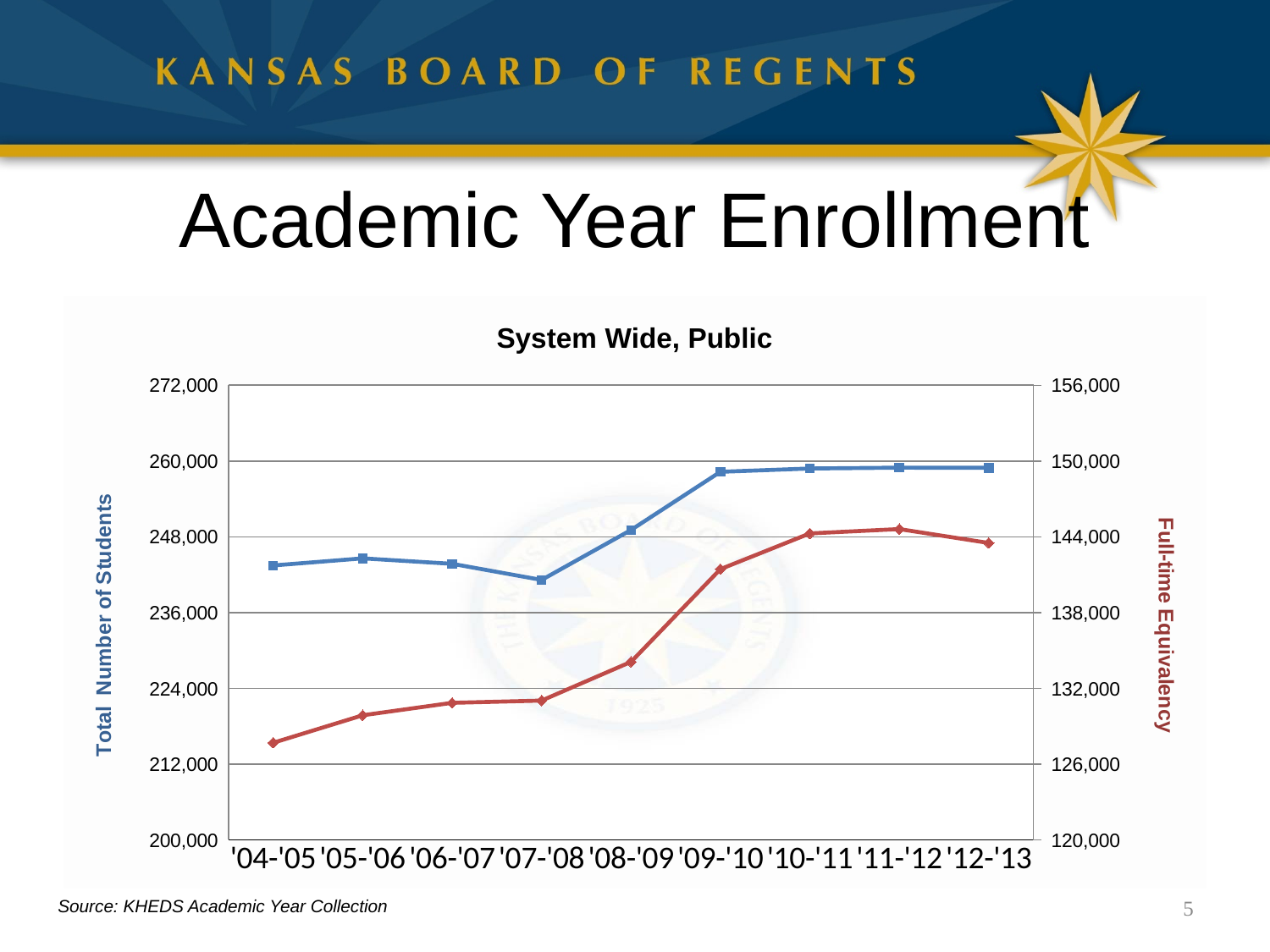
What is the title of the chart? System Wide, Public Is the Full-time Equivalency for '08-'09 greater or less than 132,000? greater How many academic years are plotted along the x axis? 9 Is the Total Number of Students for '09-'10 greater or less than 248,000? greater Does the Full-time Equivalency generally rise or fall from '04-'05 to '11-'12? rise Is the Total Number of Students for '12-'13 greater or less than 260,000? less What kind of chart is shown on the slide? Line chart Which academic year has the lowest Total Number of Students? '07-'08 Which academic year has the lowest Full-time Equivalency? '04-'05 What does the left vertical axis measure? Total Number of Students Which is larger, the Total Number of Students in '09-'10 or in '04-'05? '09-'10